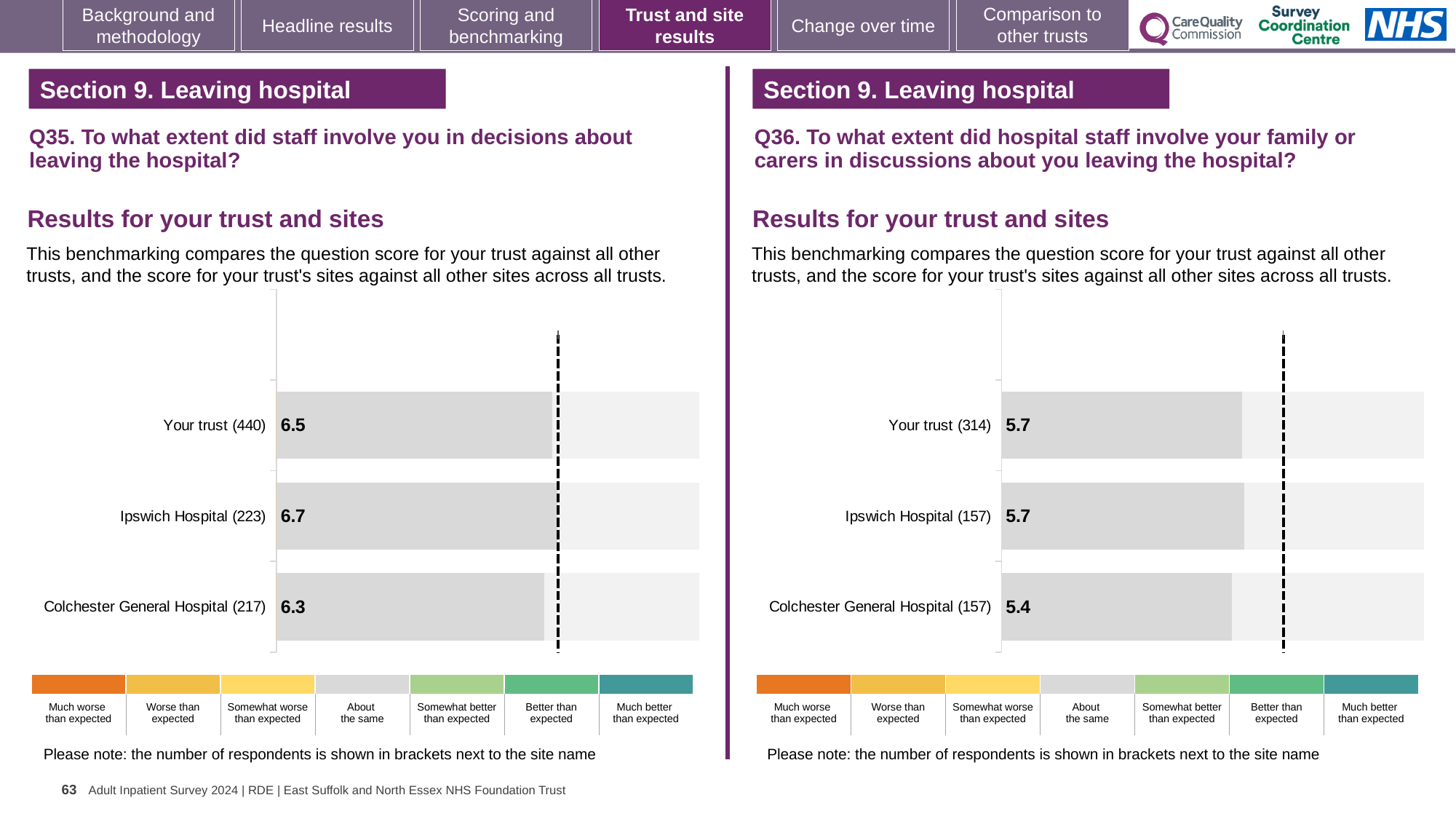
In the Q35 chart (left), what is the score for Your trust? 6.5 In the Q36 chart (right), what is the difference between the scores for Your trust and Colchester General Hospital? 0.3 In the Q35 chart (left), which site or trust has the lowest score? Colchester General Hospital What kind of chart is used for the Q36 results (right)? bar chart In the Q36 chart (right), which site has the lowest score? Colchester General Hospital In the Q36 chart (right), what is the score for Colchester General Hospital? 5.4 In the Q35 chart (left), what is the score for Colchester General Hospital? 6.3 How many bars are plotted in the Q35 chart (left)? 3 In the Q36 chart (right), is the score for Your trust larger or smaller than the score for Colchester General Hospital? larger In the Q35 chart (left), what is the difference between the scores for Ipswich Hospital and Colchester General Hospital? 0.4 In the Q36 chart (right), what is the score for Ipswich Hospital? 5.7 In the Q35 chart (left), which site or trust has the highest score? Ipswich Hospital